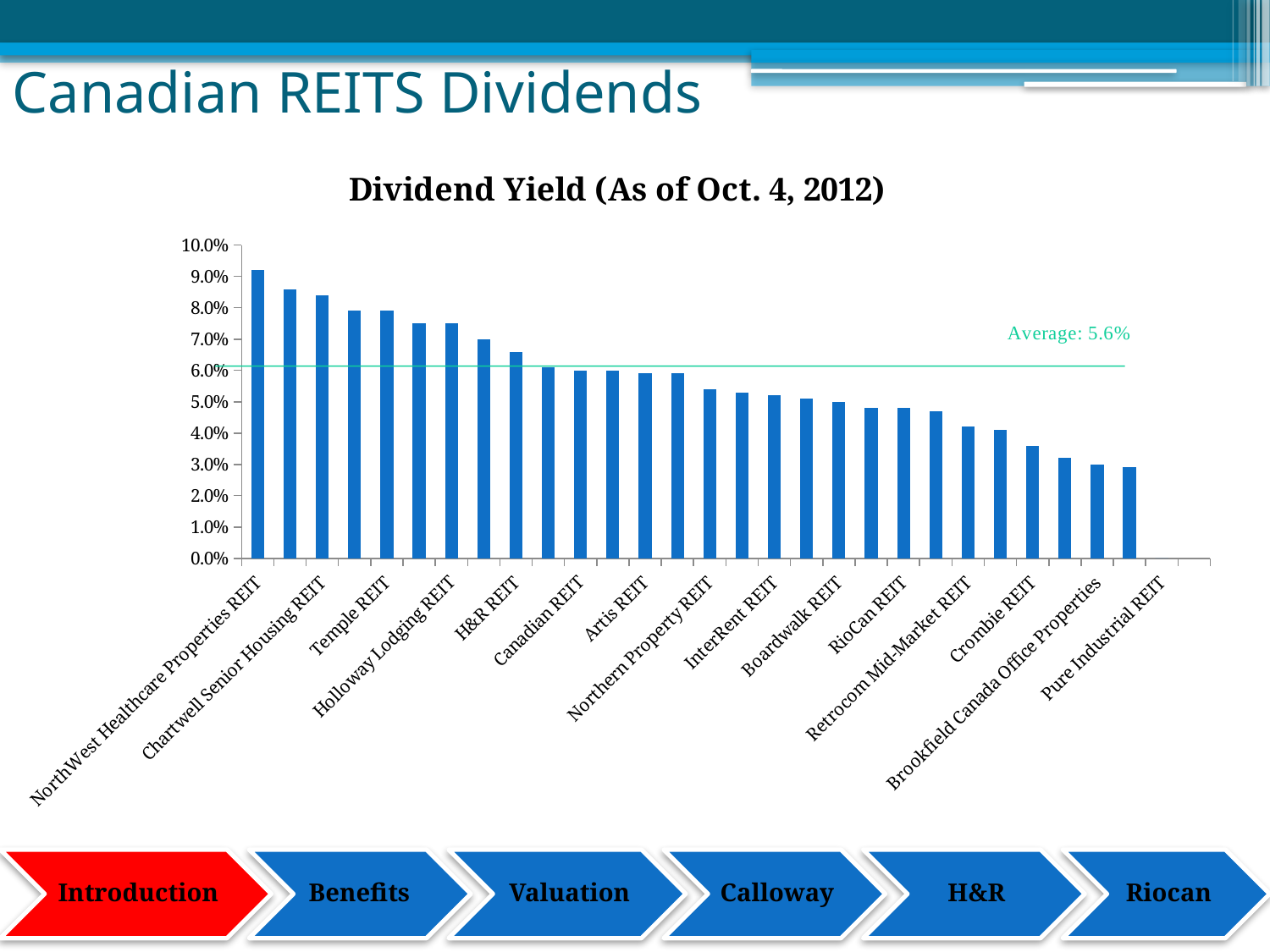
Is the lowest bar on the chart greater or less than 4.0%? Less Which REIT has the highest dividend yield on the chart? NorthWest Healthcare Properties REIT Is the dividend yield for NorthWest Healthcare Properties REIT above or below the average line? Above What kind of chart is shown on the slide? Bar chart What is the maximum value shown on the y axis? 10.0% Is the dividend yield for NorthWest Healthcare Properties REIT greater or less than 8.0%? Greater How many REIT names are labelled on the x axis? 15 Do the dividend yields rise or fall moving from left to right along the x axis? Fall What average dividend yield is annotated on the chart? 5.6% What is the title of the chart? Dividend Yield (As of Oct. 4, 2012)